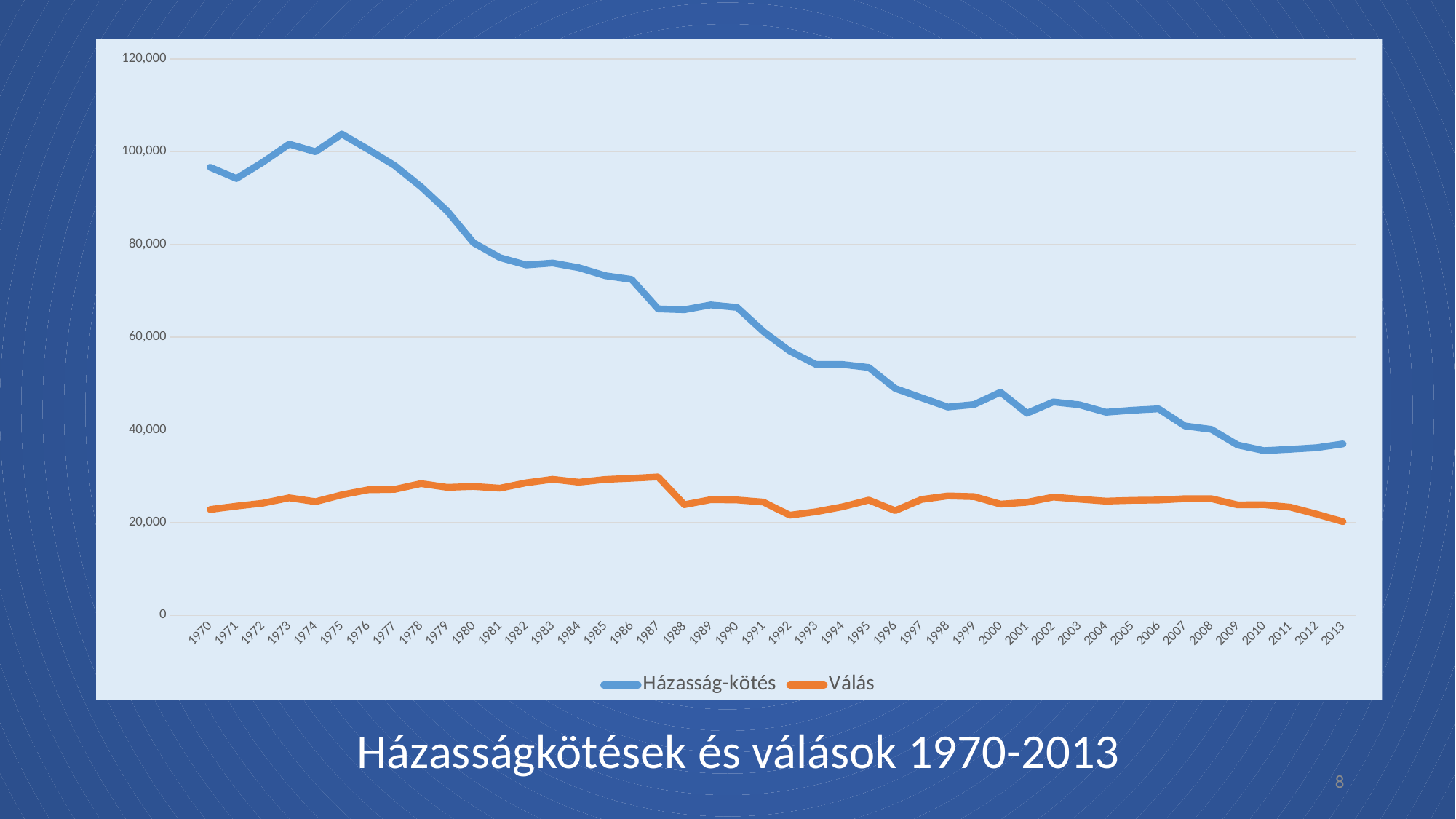
Which is larger: Házasság-kötés in 1970 or Házasság-kötés in 1975? 1975 Is the value for Házasság-kötés in 1990 greater or less than 60,000? greater In which year does the Válás series reach its highest value? 1987 In which year does the Válás series reach its lowest value? 2013 How many years are plotted along the x axis? 44 Is the value for Házasság-kötés in 1975 greater or less than 100,000? greater What is the title shown below the chart? Házasságkötések és válások 1970-2013 What kind of chart is shown on the slide? line chart Does the Házasság-kötés series overall rise or fall from 1970 to 2013? fall How many series does the legend list? 2 Is the value for Házasság-kötés in 2013 greater or less than 40,000? less In which year does the Házasság-kötés series reach its highest value? 1975